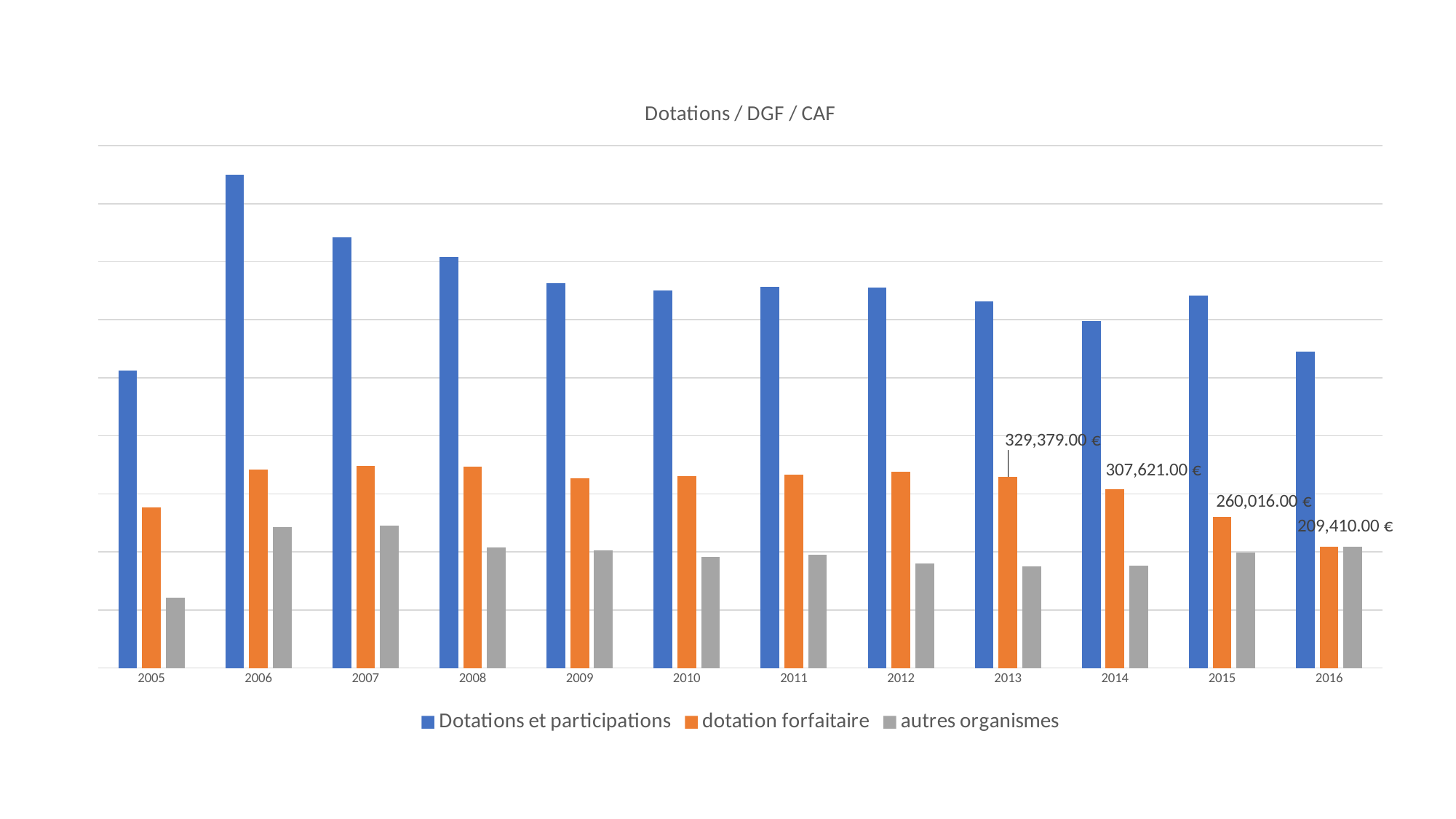
In which year is Dotations et participations highest? 2006 What is the title of the chart? Dotations / DGF / CAF What is the difference between dotation forfaitaire in 2015 and in 2016? 50,606.00 € How many series does the legend list? 3 What is the value of dotation forfaitaire in 2015? 260,016.00 € What is the value of dotation forfaitaire in 2014? 307,621.00 € By how much did dotation forfaitaire decrease from 2013 to 2014? 21,758.00 € What is the value of dotation forfaitaire in 2016? 209,410.00 € What kind of chart is shown on the slide? bar chart In which year is Dotations et participations lowest? 2005 What is the value of dotation forfaitaire in 2013? 329,379.00 € How many years are shown on the x axis? 12